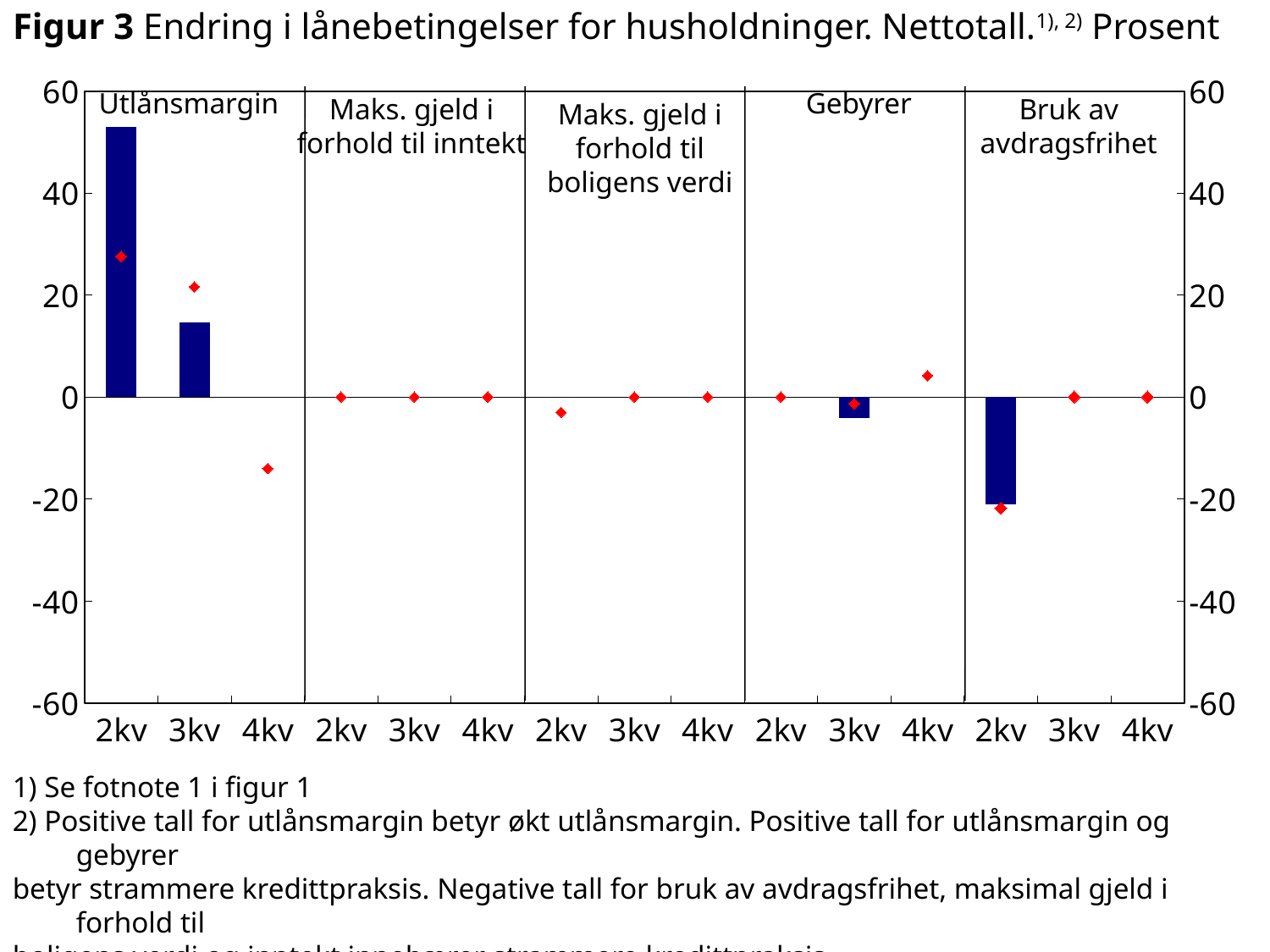
Is the bar for Utlånsmargin in 3kv greater or less than 20? less Is the bar for Bruk av avdragsfrihet in 2kv greater or less than -10? less Which bar is larger for Utlånsmargin: 2kv or 3kv? 2kv How many loan-condition categories (panels) are shown along the x axis? 5 How many quarters are shown within each panel of the chart? 3 Do the bars for Utlånsmargin rise or fall from 2kv to 4kv? fall Which category has the tallest bar in the chart? Utlånsmargin Which category has the lowest (most negative) bar in the chart? Bruk av avdragsfrihet Is the red diamond marker for Utlånsmargin in 4kv greater or less than 0? less What kind of chart is shown in Figur 3? bar chart What is the maximum value shown on the vertical axis? 60